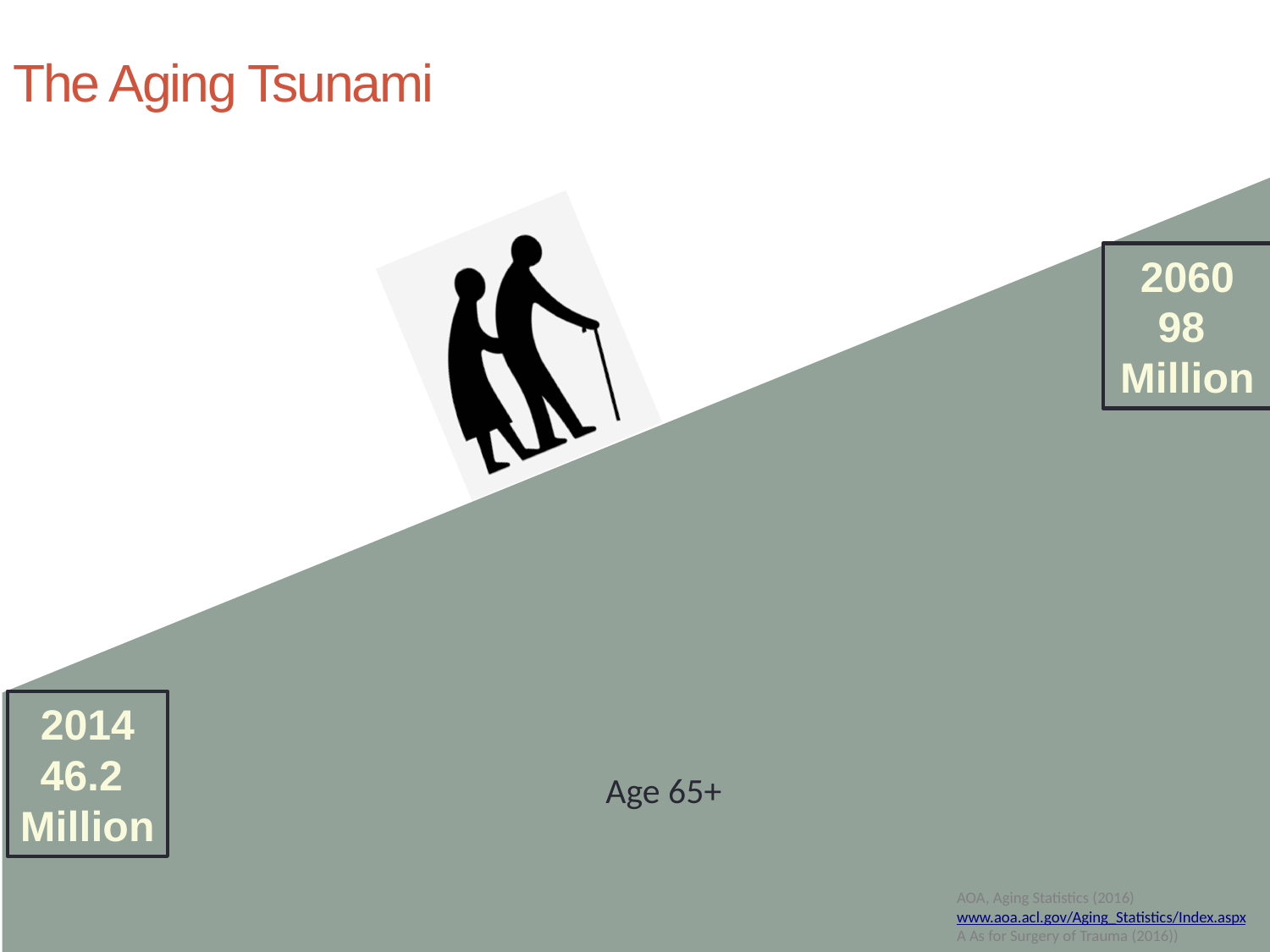
What is the value shown for 2060? 98 Million What is the value shown for 2014? 46.2 Million Which year shows the higher value, 2014 or 2060? 2060 What is the title of the slide? The Aging Tsunami What is the difference between the 2060 value and the 2014 value? 51.8 Million Does the value rise or fall from 2014 to 2060? rise Which age group do the values on the slide refer to? Age 65+ How many years are labelled with values on the slide? 2 Which year shows the lowest value? 2014